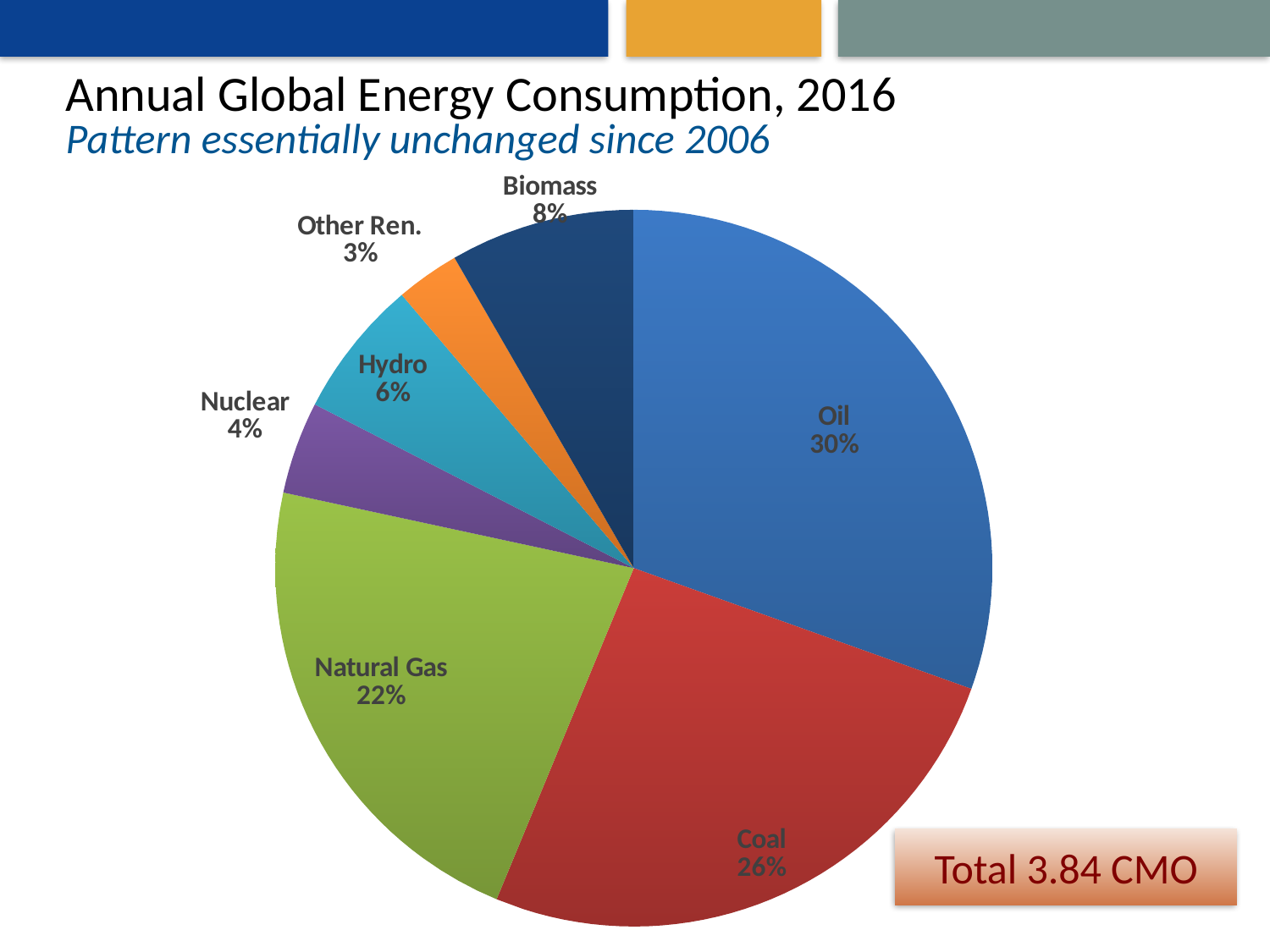
Which energy source has the smallest slice of the pie? Other Ren. Which energy source has the largest slice of the pie? Oil What share of annual global energy consumption in 2016 does Oil account for? 30% What share does Hydro have in the pie chart? 6% What kind of chart is shown on the slide? Pie chart What is the difference in percentage points between Biomass and Nuclear? 4 What is the difference in percentage points between Oil and Coal? 4 How many energy sources are shown in the pie chart? 7 Which is larger, the share for Hydro or the share for Biomass? Biomass Which is larger, the share for Coal or the share for Natural Gas? Coal What percentage of the pie is Natural Gas? 22% What total is stated in the box next to the pie chart? Total 3.84 CMO